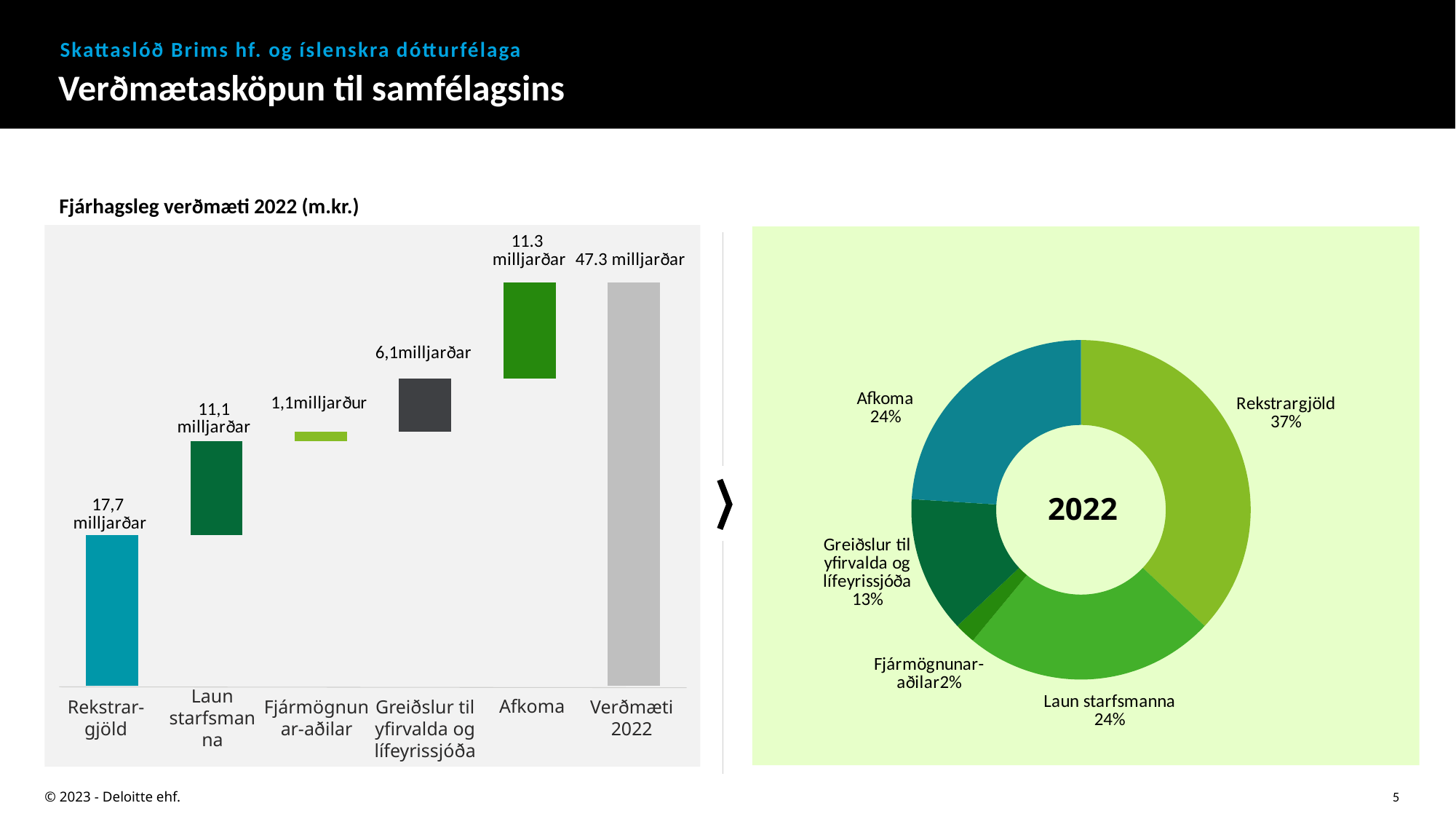
In the right donut chart labelled 2022, which category has the smallest share? Fjármögnunar-aðilar In the left chart 'Fjárhagsleg verðmæti 2022 (m.kr.)', what is the value labelled for Afkoma? 11.3 milljarðar In the left chart 'Fjárhagsleg verðmæti 2022 (m.kr.)', what is the value labelled for Rekstrargjöld? 17,7 milljarðar In the left chart 'Fjárhagsleg verðmæti 2022 (m.kr.)', what is the value labelled for Verðmæti 2022? 47.3 milljarðar In the left chart 'Fjárhagsleg verðmæti 2022 (m.kr.)', what is the value labelled for Greiðslur til yfirvalda og lífeyrissjóða? 6,1milljarðar What kind of chart is the left chart 'Fjárhagsleg verðmæti 2022 (m.kr.)'? Bar chart In the right donut chart labelled 2022, what share does Greiðslur til yfirvalda og lífeyrissjóða have? 13% In the left chart 'Fjárhagsleg verðmæti 2022 (m.kr.)', how many categories are shown on the x axis? 6 In the right donut chart labelled 2022, how many percentage points larger is the Rekstrargjöld share than the Laun starfsmanna share? 13 In the right donut chart labelled 2022, what share does Rekstrargjöld have? 37% In the right donut chart labelled 2022, which category has the largest share? Rekstrargjöld In the left chart 'Fjárhagsleg verðmæti 2022 (m.kr.)', which category has the smallest labelled value? Fjármögnunar-aðilar